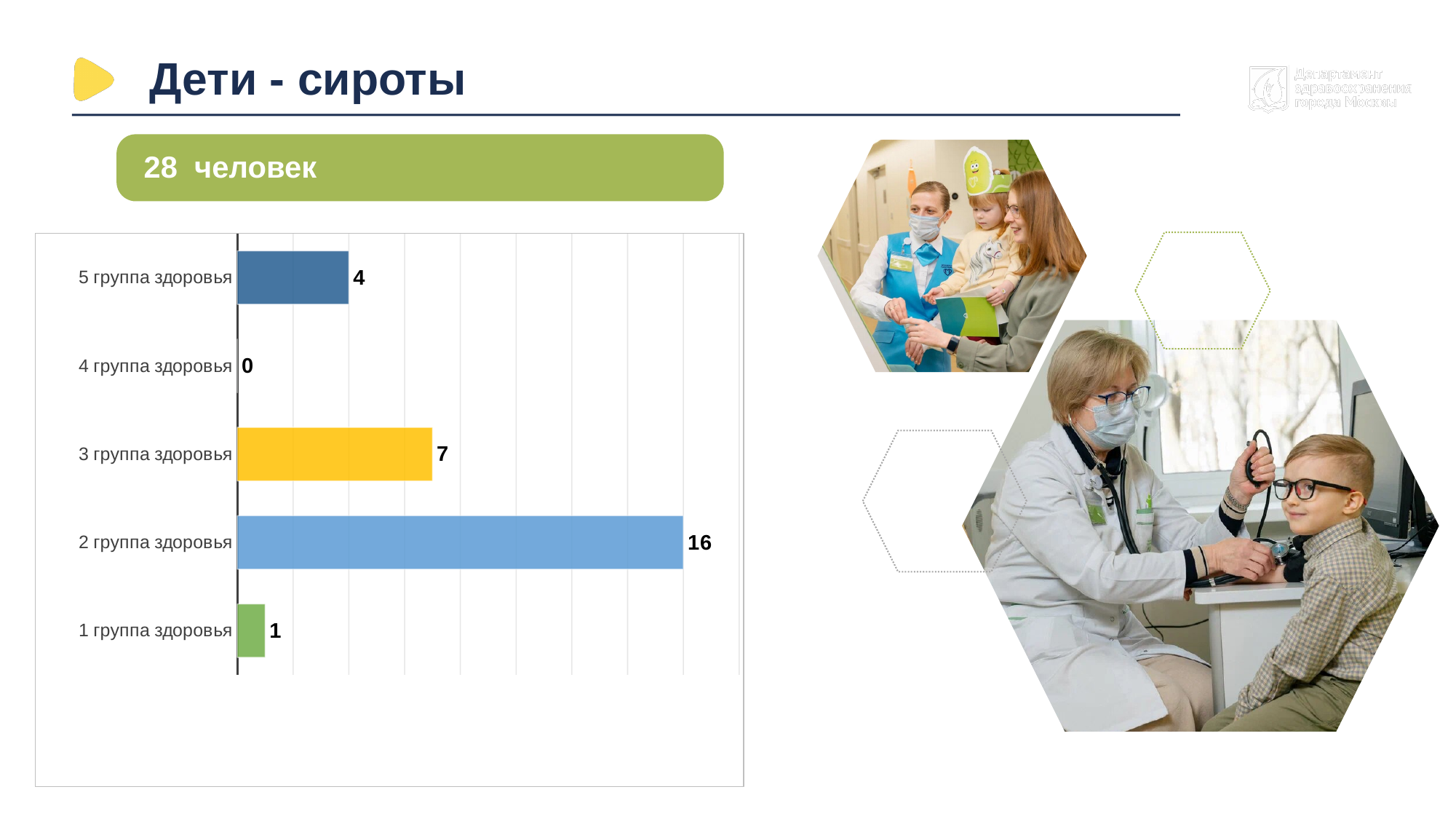
Which is larger, the value for 5 группа здоровья or 1 группа здоровья? 5 группа здоровья What kind of chart is shown on the slide? Bar chart What is the difference between the values for 2 группа здоровья and 3 группа здоровья? 9 Which health group has the highest value? 2 группа здоровья What is the value for 3 группа здоровья? 7 What is the value for 5 группа здоровья? 4 How many categories are shown in the chart? 5 What is the value for 4 группа здоровья? 0 Which health group has the lowest value? 4 группа здоровья What is the total of all the values shown in the chart? 28 What is the value for 2 группа здоровья? 16 What colour is the bar for 3 группа здоровья? Yellow